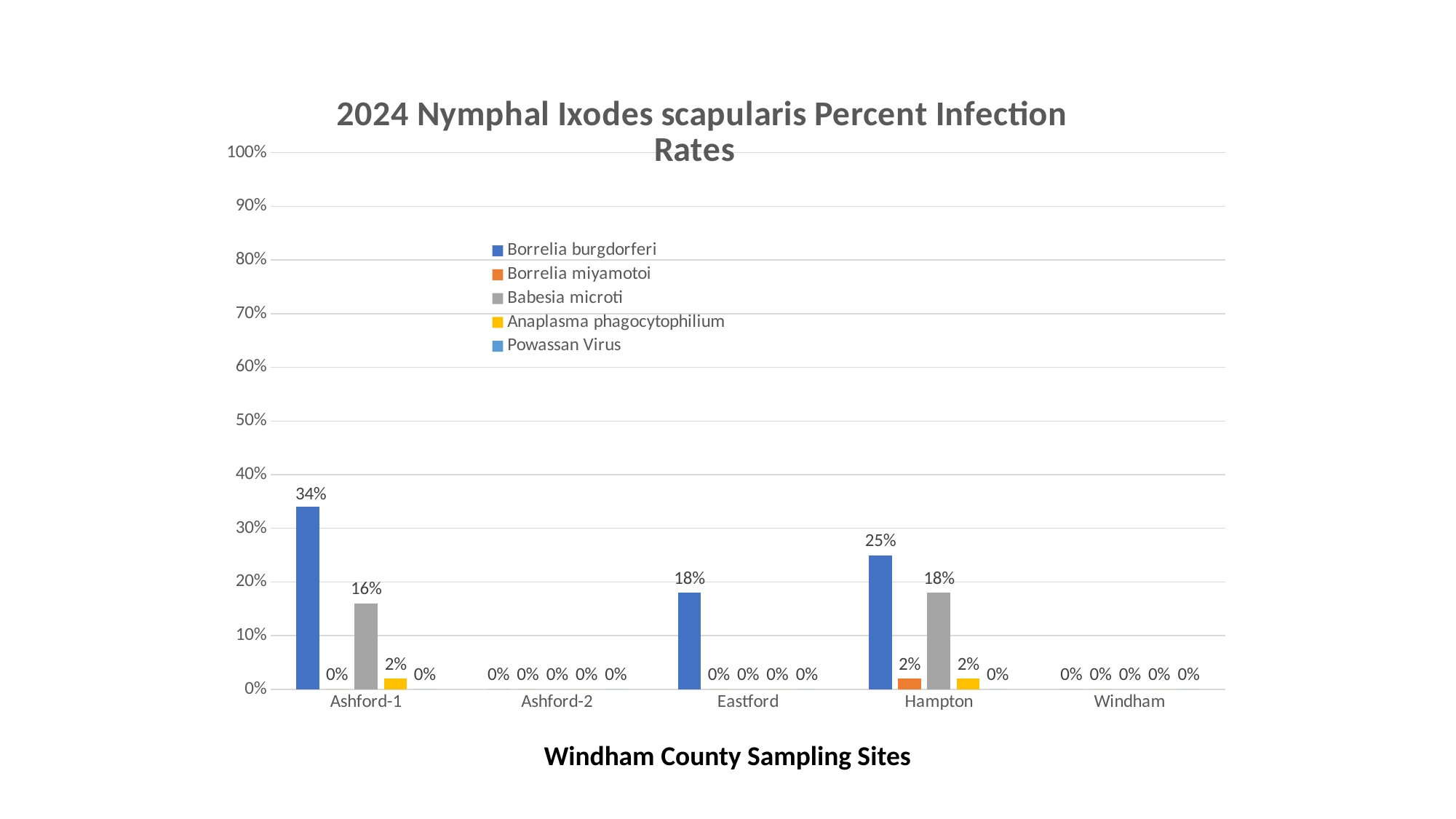
Which is larger: the Babesia microti rate at Ashford-1 or at Hampton? Hampton Is the Borrelia burgdorferi value for Ashford-1 greater or less than 30%? greater Which sampling site has the highest Borrelia burgdorferi infection rate? Ashford-1 How many series does the legend list? 5 What is the Babesia microti infection rate at Hampton? 18% How many sampling sites are shown on the x axis? 5 What is the Borrelia miyamotoi infection rate at Hampton? 2% What is the Borrelia burgdorferi infection rate at Ashford-1? 34% What is the Borrelia burgdorferi infection rate at Eastford? 18% What is the x-axis title of the chart? Windham County Sampling Sites What is the difference between the Borrelia burgdorferi rates at Ashford-1 and Hampton? 9% What kind of chart is shown on the slide? Bar chart